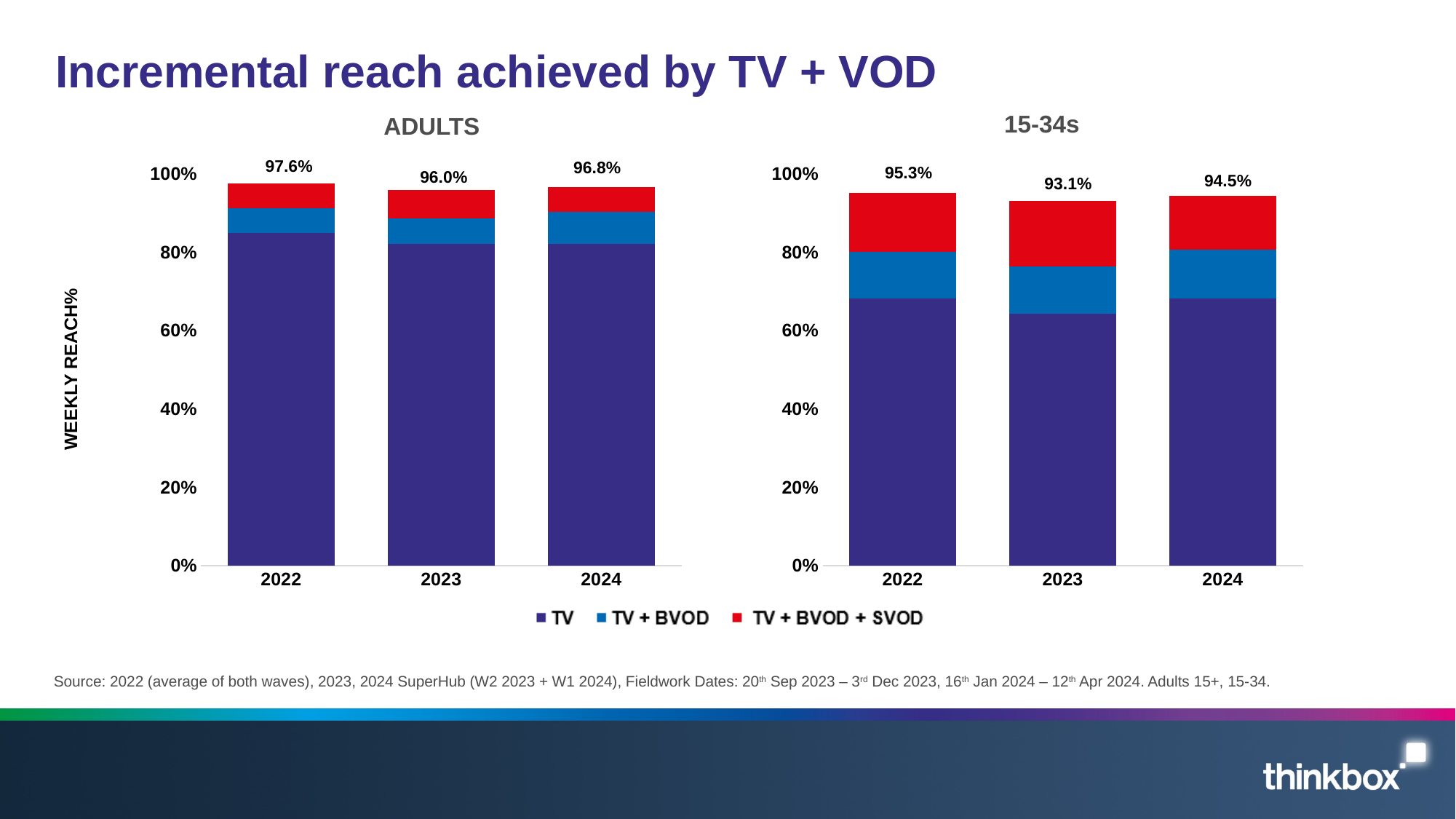
In the ADULTS chart, what is the difference between the total reach in 2022 and in 2023? 1.6 percentage points In the 15-34s chart, what is the difference between the total reach in 2022 and in 2023? 2.2 percentage points In the 15-34s chart, what is the total weekly reach shown for 2023? 93.1% What kind of chart is the ADULTS chart? Stacked bar chart In the ADULTS chart, what is the total weekly reach shown for 2022? 97.6% In the 15-34s chart, is the TV-only value for 2022 greater or less than 80%? less In the 15-34s chart, what is the total weekly reach shown for 2024? 94.5% Which is larger: the 2024 total reach in the ADULTS chart or the 2024 total reach in the 15-34s chart? ADULTS (96.8%) In the 15-34s chart, which year has the lowest total weekly reach? 2023 In the ADULTS chart, is the TV-only value for 2022 greater or less than 80%? greater How many series does the legend list? 3 In the ADULTS chart, which year has the highest total weekly reach? 2022